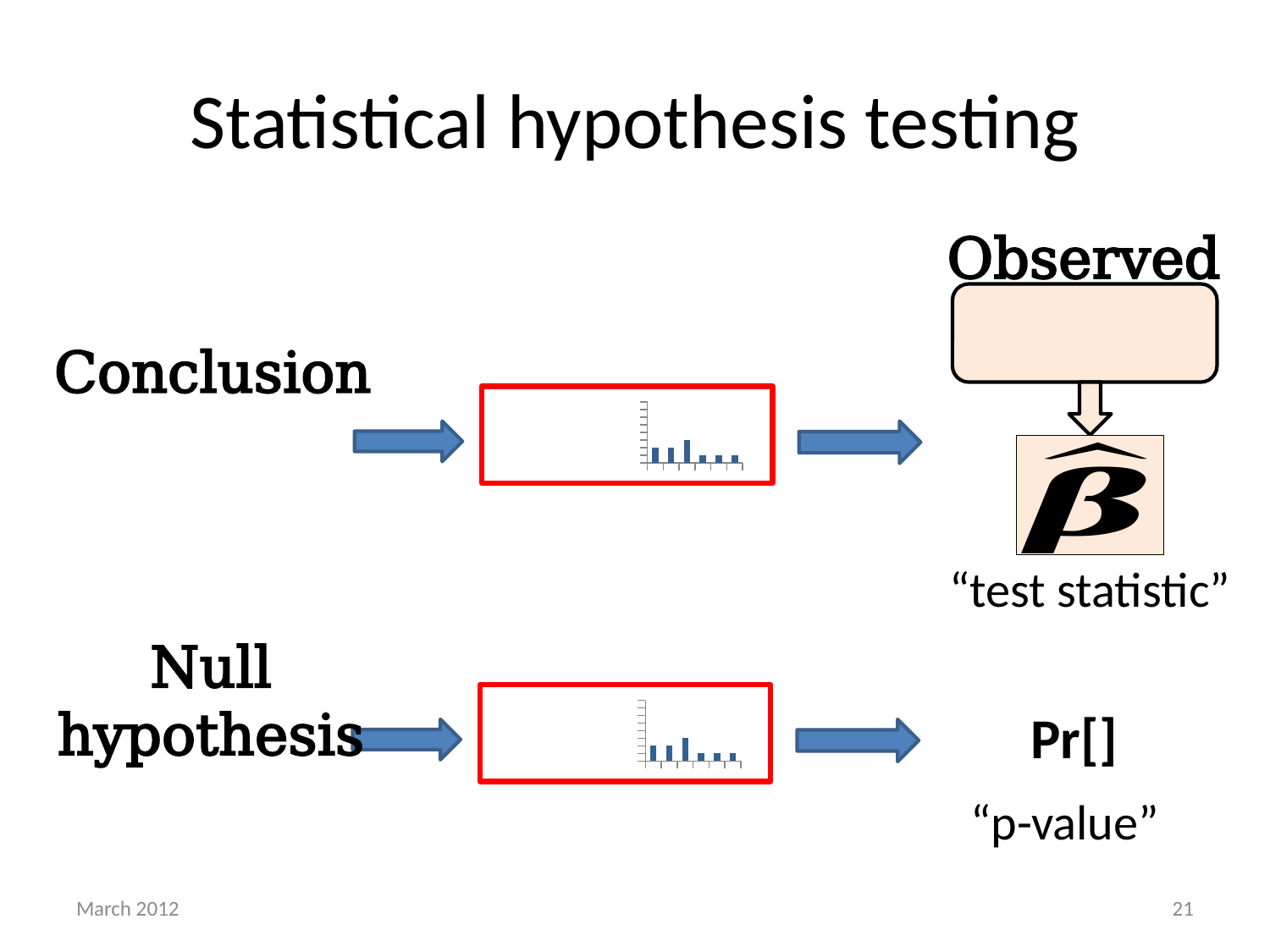
In the bottom-row chart, is the leftmost bar the tallest bar? no How many charts are shown on the slide? 2 What colour is the border drawn around each chart on the slide? red Are the bars in the top-row chart vertical or horizontal? vertical What kind of chart is shown inside the red box in the bottom row of the slide? bar chart In the top-row chart, is the leftmost bar the tallest bar? no What kind of chart is shown inside the red box in the top row of the slide? bar chart